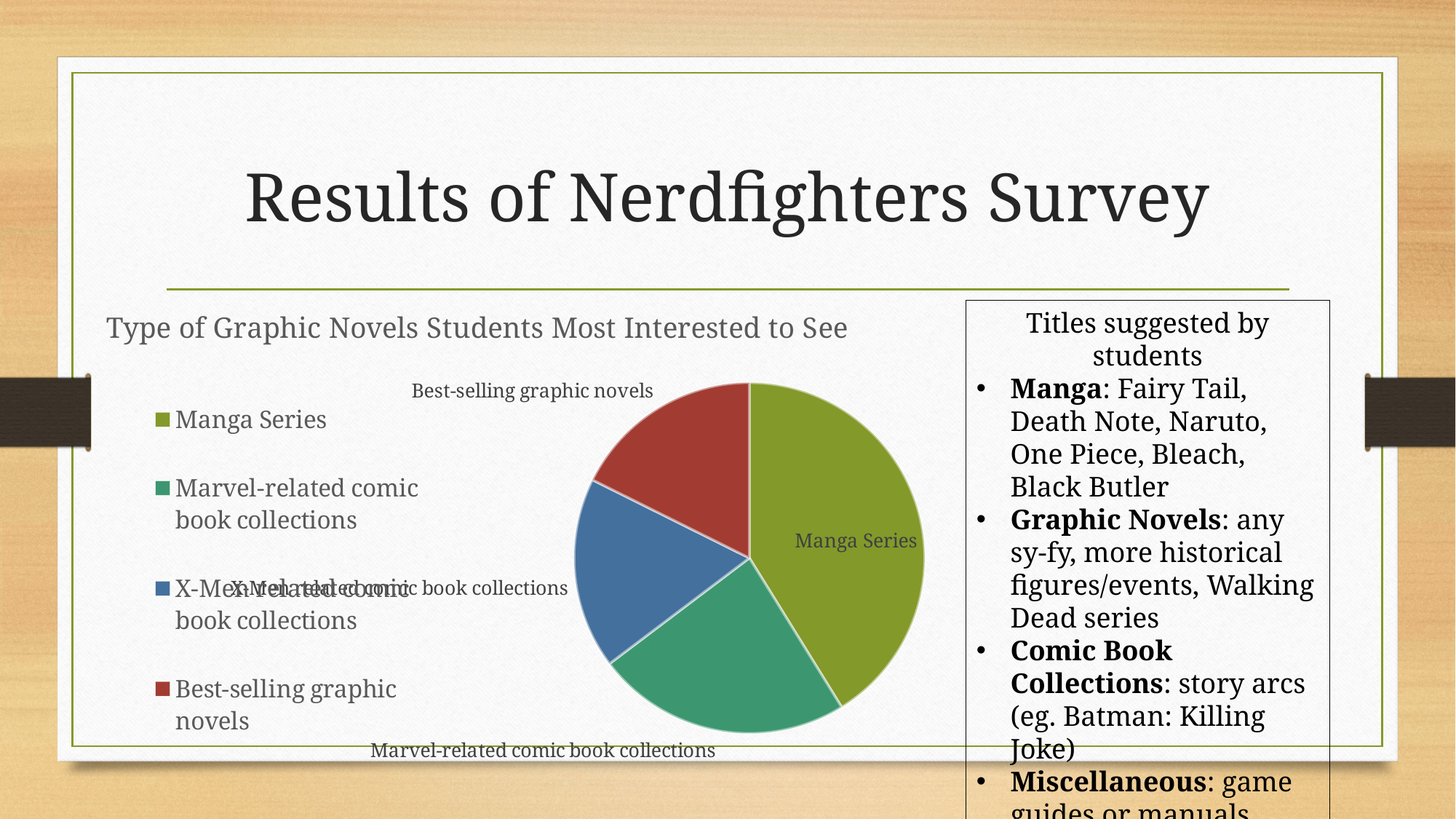
What is the title of the pie chart? Type of Graphic Novels Students Most Interested to See Which category has the largest slice in the pie chart? Manga Series What colour is the Manga Series slice in the pie chart? green What kind of chart is shown on the slide? pie chart How many slices does the pie chart have? 4 How many entries does the legend of the pie chart list? 4 Which slice is larger: Manga Series or X-Men-related comic book collections? Manga Series Which slice is larger: Manga Series or Best-selling graphic novels? Manga Series Which slice is larger: Marvel-related comic book collections or Best-selling graphic novels? Marvel-related comic book collections